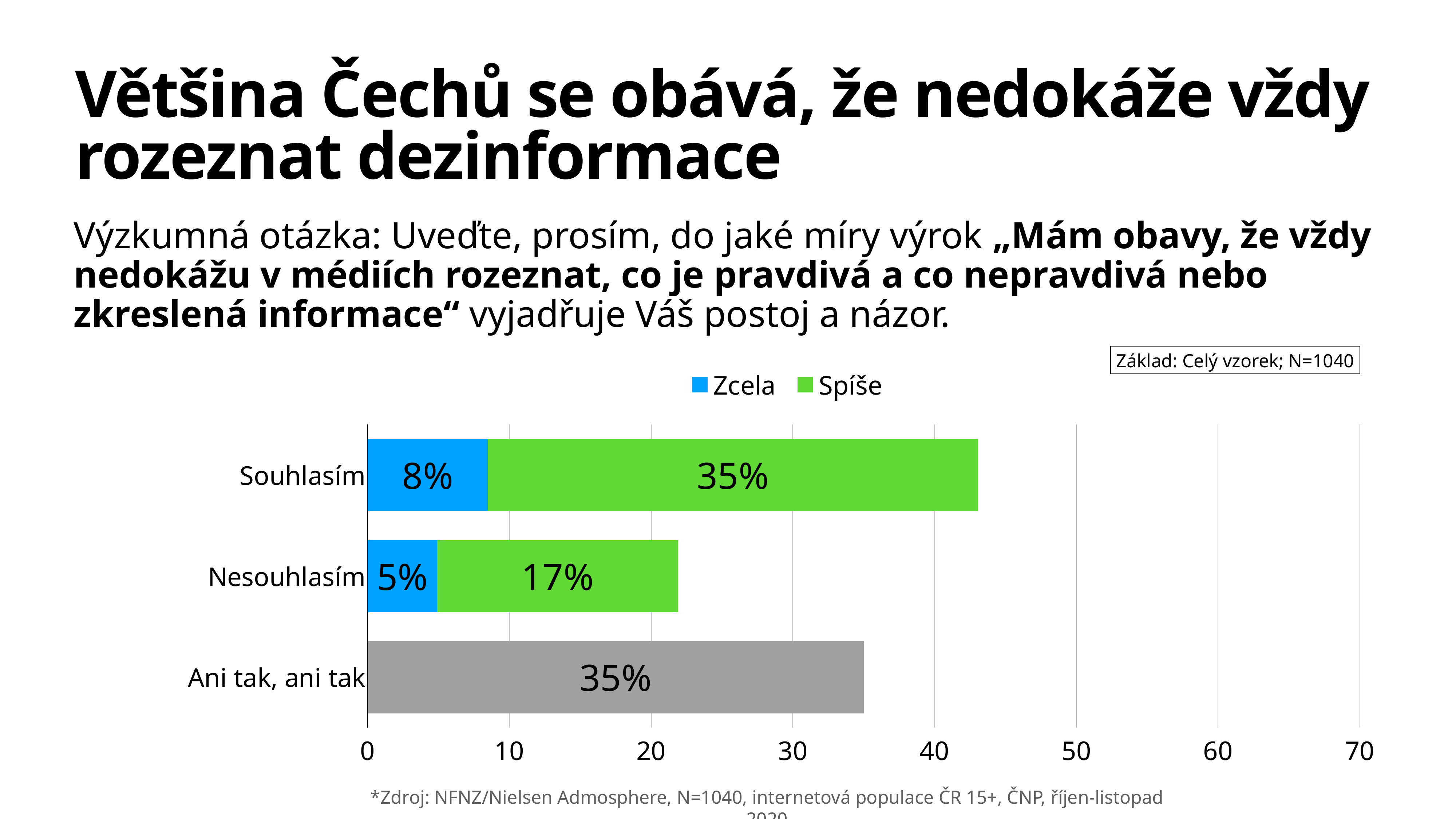
What is the "Spíše" value for Nesouhlasím? 17% What is the total of the stacked bar for Nesouhlasím? 22% Which category has the shortest bar overall? Nesouhlasím How many series does the legend list? 2 What is the difference between the "Spíše" values for Souhlasím and Nesouhlasím? 18% Which category has the longest bar overall? Souhlasím What is the value shown for Ani tak, ani tak? 35% What is the "Zcela" value for Souhlasím? 8% What is the "Zcela" value for Nesouhlasím? 5% What kind of chart is shown on the slide? stacked bar chart Is the "Zcela" value for Souhlasím larger or smaller than the "Zcela" value for Nesouhlasím? larger What is the total of the stacked bar for Souhlasím? 43%